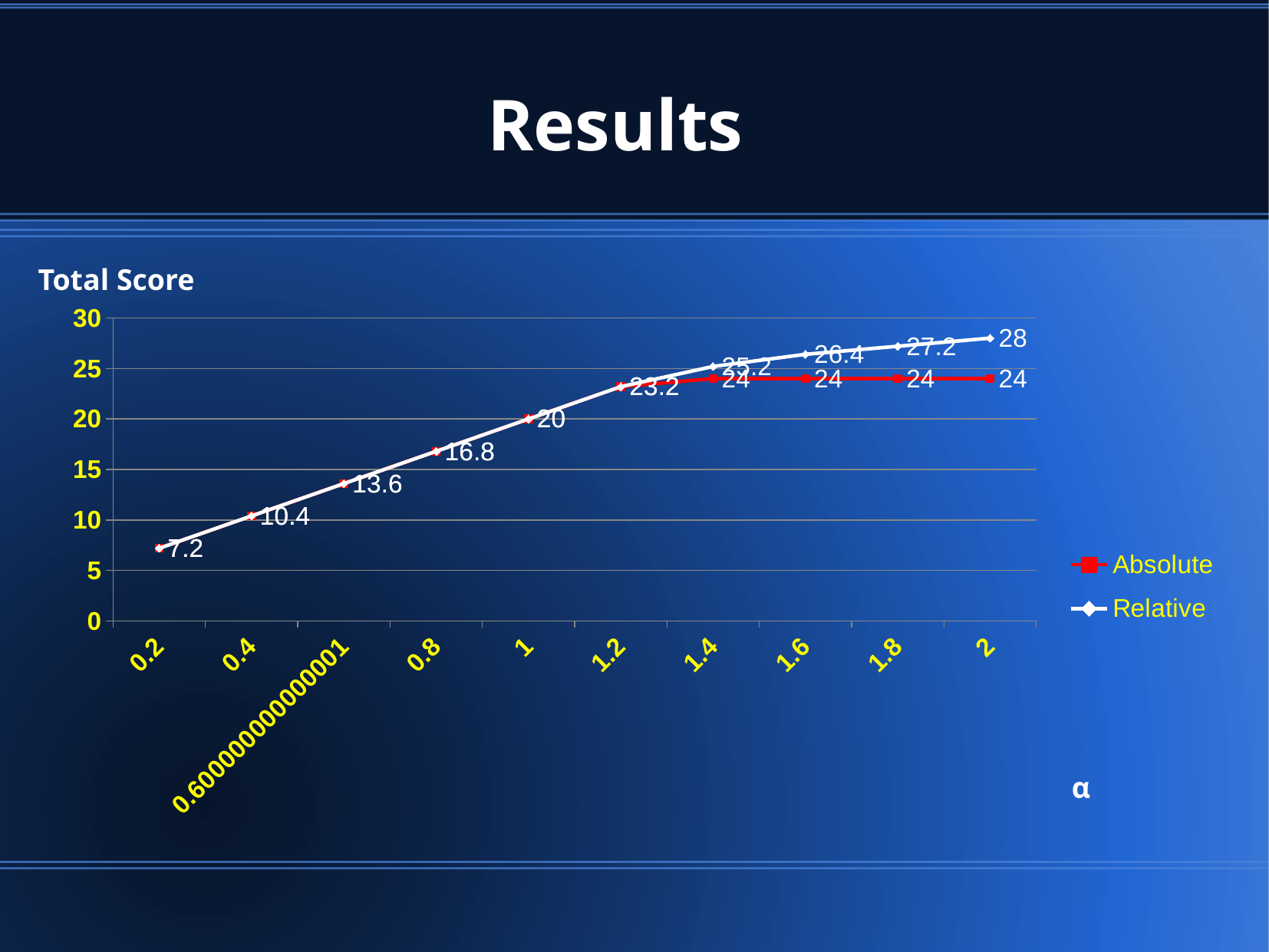
What is the Absolute value at α = 1.8? 24 At which α value is the Relative series highest? 2 What is the difference between the Relative and Absolute values at α = 2? 4 What is the Relative value at α = 2? 28 What is the title of the vertical axis? Total Score What is the Relative value at α = 1? 20 Does the Relative series rise or fall as α increases from 0.2 to 2? rise What is the Relative value at α = 0.2? 7.2 How many series does the legend list? 2 What is the Relative value at α = 1.6? 26.4 What kind of chart is shown on the slide? line chart At α = 1.6, which series has the larger value, Absolute or Relative? Relative